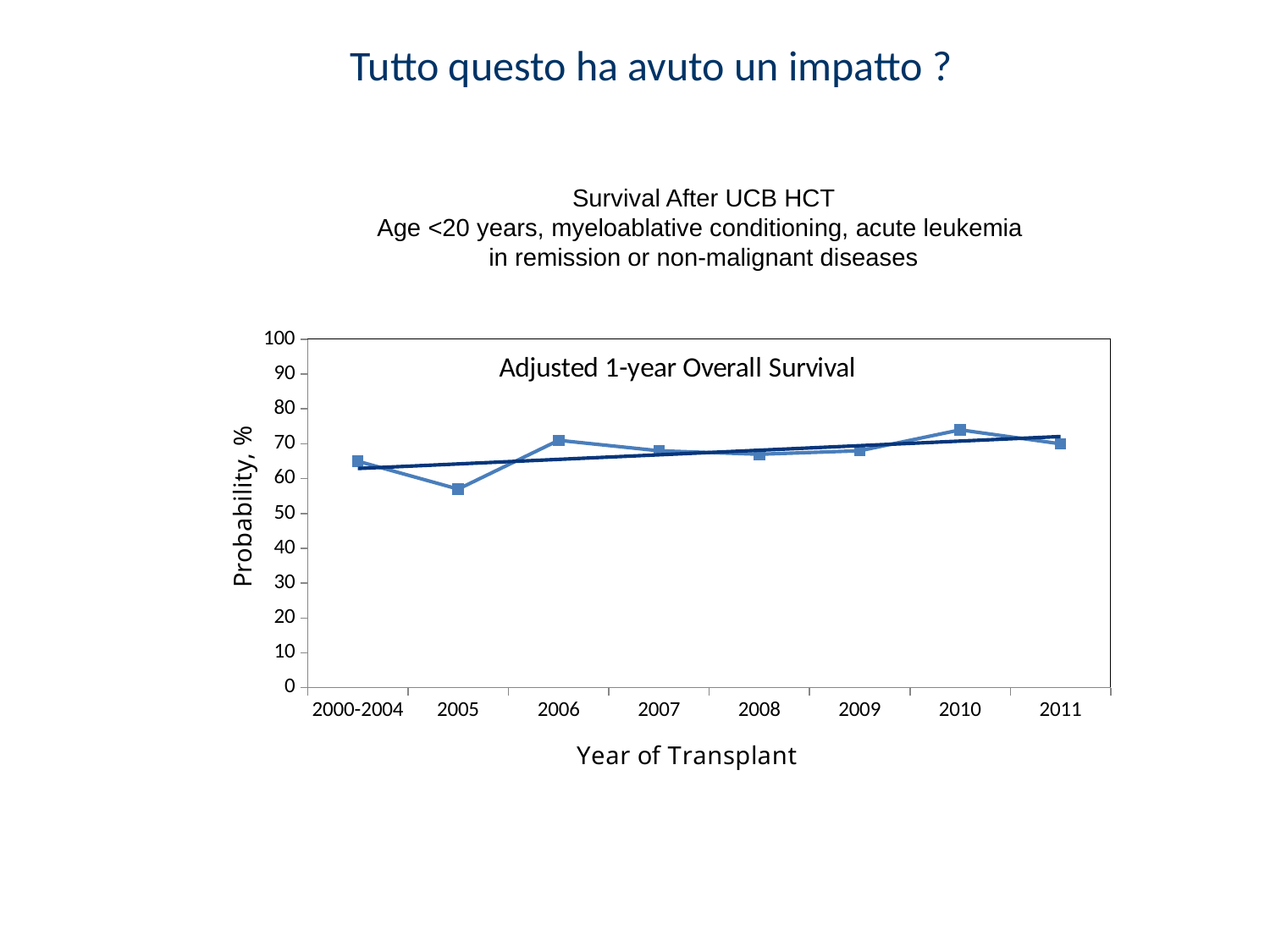
Is the survival probability for 2000-2004 greater or less than 60? greater What is the label of the y axis of the chart? Probability, % Is the survival probability for 2005 greater or less than 60? less Does the straight trend line in the chart rise or fall from 2000-2004 to 2011? rise Is the survival probability for 2010 greater or less than 70? greater What kind of chart is shown on the slide? line chart Which has the higher survival probability, 2005 or 2010? 2010 Which year of transplant has the highest adjusted 1-year overall survival? 2010 Which year of transplant has the lowest adjusted 1-year overall survival? 2005 What is the label of the x axis of the chart? Year of Transplant How many year categories are shown on the x axis of the chart? 8